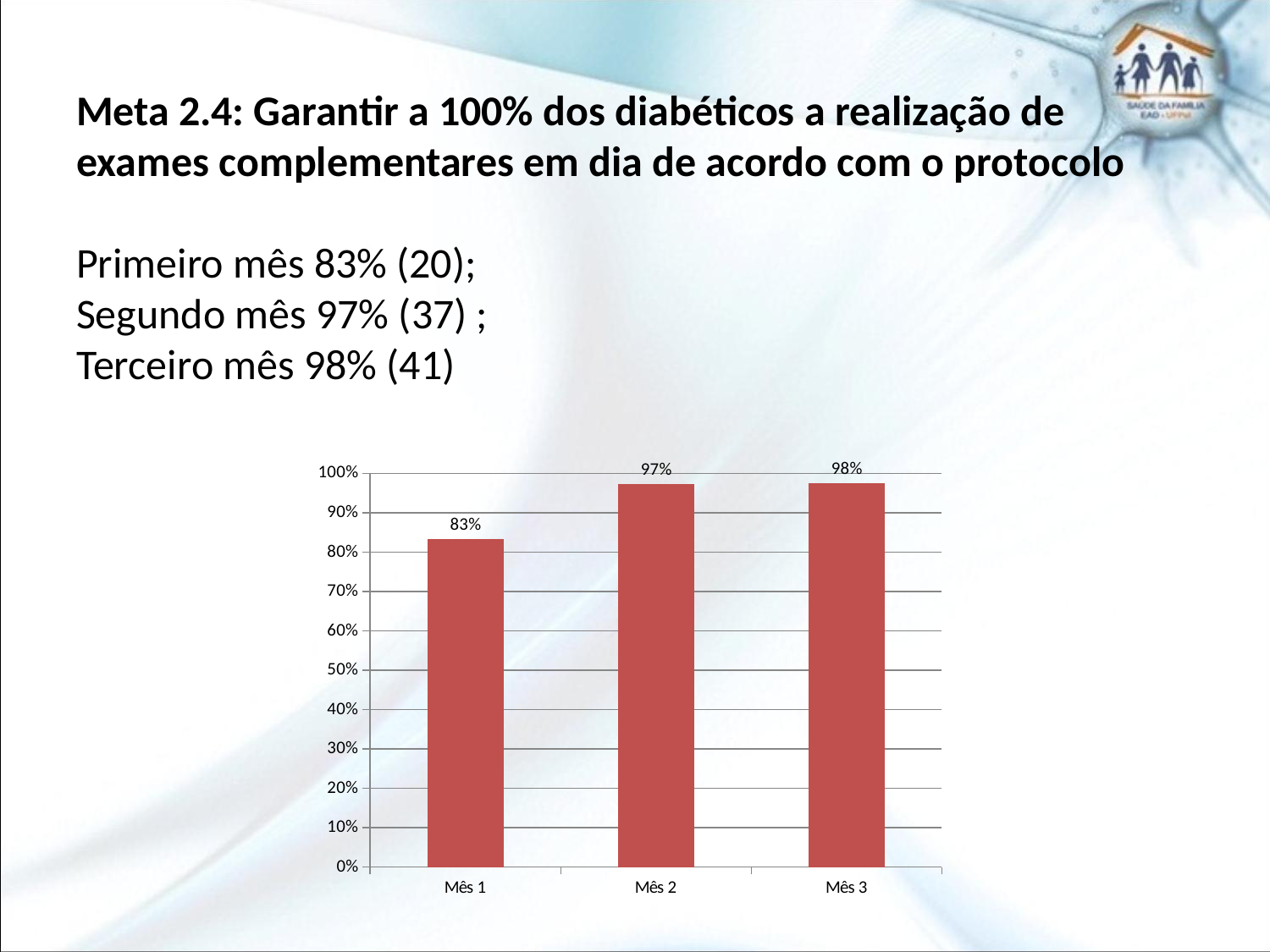
What is the value for Mês 1? 83% What is the value for Mês 2? 97% Is the value for Mês 1 greater or less than 90%? less What is the difference between the values for Mês 2 and Mês 1? 14% What kind of chart is shown on the slide? bar chart Which is larger, the value for Mês 1 or the value for Mês 2? Mês 2 What is the highest value shown on the y axis? 100% What is the value for Mês 3? 98% How many categories are shown on the x axis? 3 What is the difference between the values for Mês 3 and Mês 1? 15% Do the values rise or fall from Mês 1 to Mês 3? rise Which month has the lowest value? Mês 1